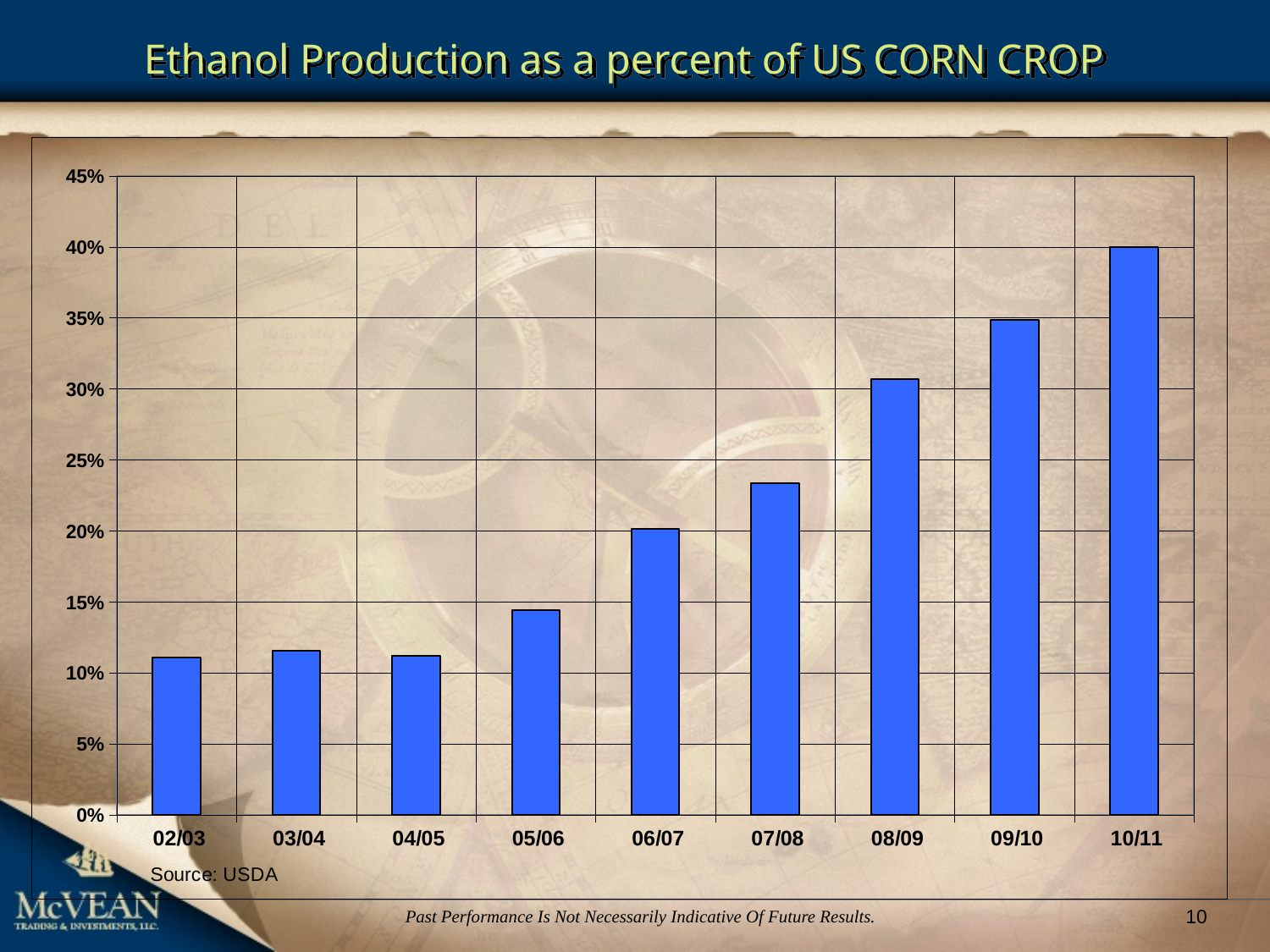
Do the values generally rise or fall from 02/03 to 10/11? rise What is the title of the chart? Ethanol Production as a percent of US CORN CROP Is the value for 05/06 greater or less than 15%? less Is the value for 07/08 greater or less than 25%? less How many crop years are shown on the x axis? 9 What source is cited for the chart data? USDA Which is larger, the value for 08/09 or the value for 07/08? 08/09 Which crop year has the highest ethanol production as a percent of the US corn crop? 10/11 What kind of chart is shown on the slide? bar chart Is the value for 03/04 greater or less than 15%? less